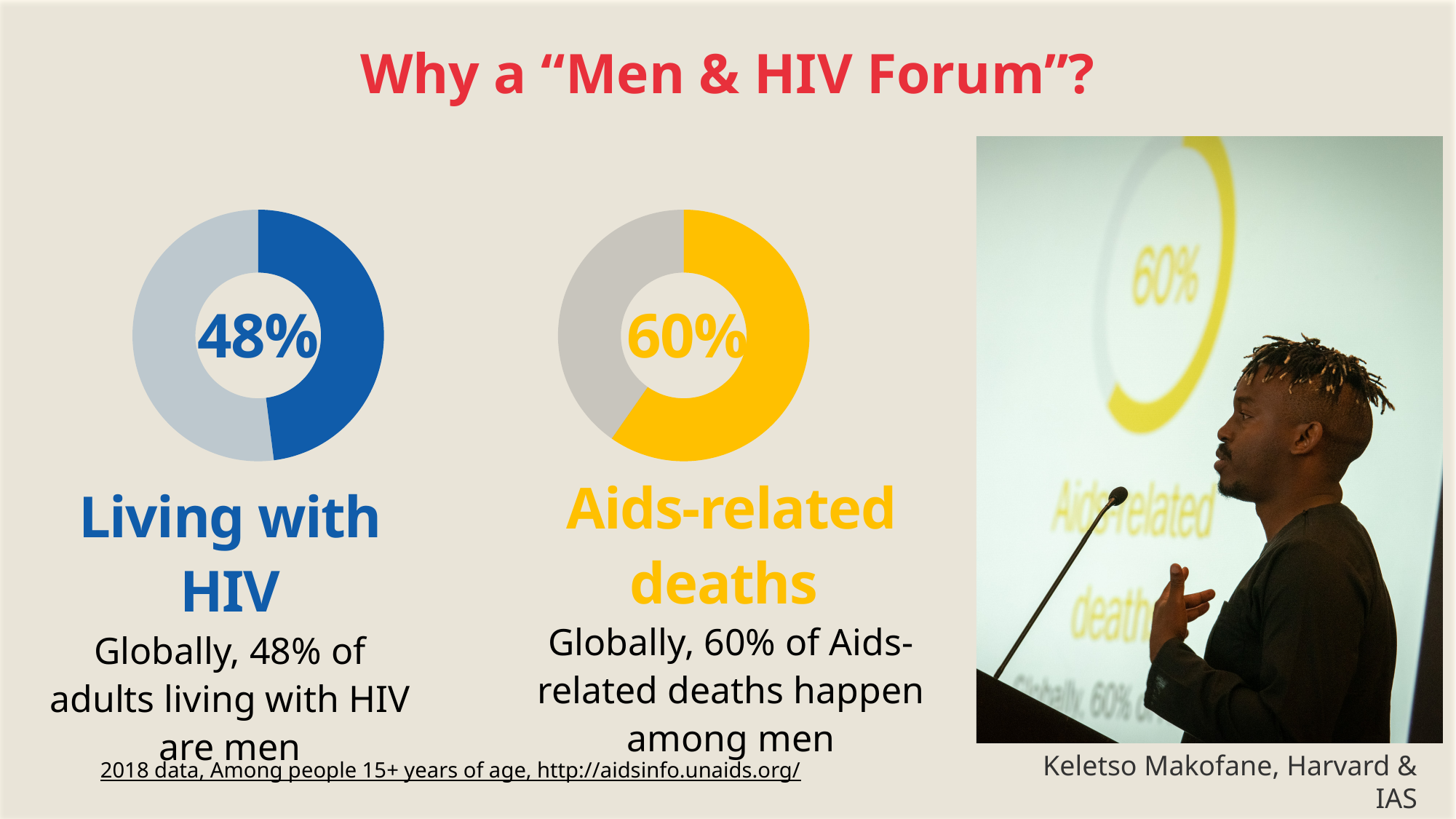
In the "Aids-related deaths" donut chart, what percentage is shown in the centre? 60% What colour is the highlighted segment in the "Aids-related deaths" donut chart? Yellow What kind of chart is used to show the 48% and 60% figures on the slide? Donut (pie) chart Which chart on the slide shows the lowest percentage? Living with HIV What colour is the highlighted segment in the "Living with HIV" donut chart? Blue In the "Living with HIV" donut chart, is the highlighted share greater or less than 50%? less How many donut charts are on the slide? 2 In the "Living with HIV" donut chart, what percentage is shown in the centre? 48% In the "Aids-related deaths" donut chart, is the highlighted share greater or less than 50%? greater What is the difference between the percentage in the "Aids-related deaths" chart and the percentage in the "Living with HIV" chart? 12% How many segments does each donut chart on the slide have? 2 Which of the two donut charts shows the higher percentage, "Living with HIV" or "Aids-related deaths"? Aids-related deaths